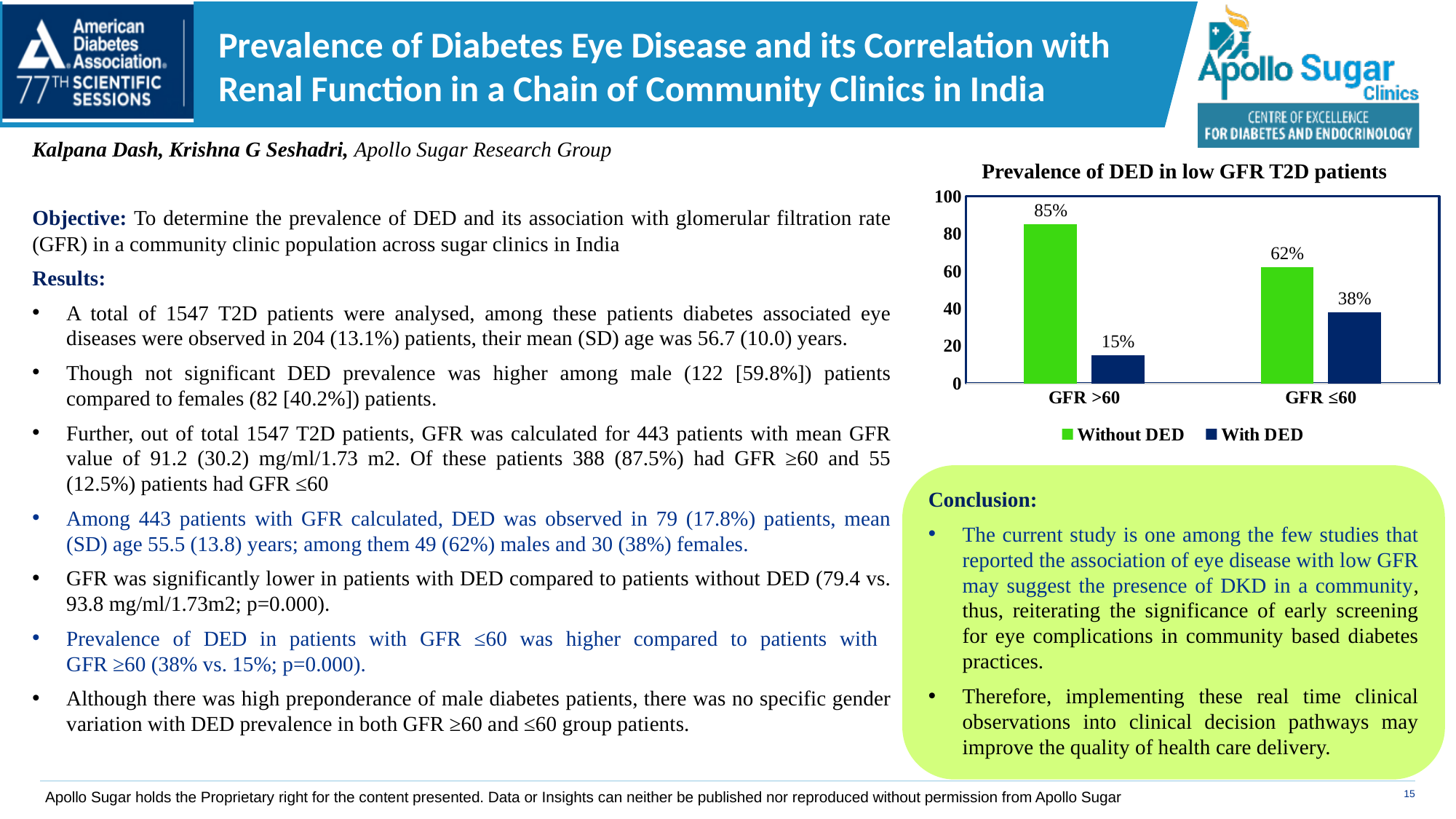
Which is larger: With DED in GFR ≤60 or With DED in GFR >60? With DED in GFR ≤60 What is the difference between the Without DED and With DED values in the GFR ≤60 group? 24% What is the value for Without DED in the GFR >60 group? 85% What is the value for With DED in the GFR >60 group? 15% Which group has the lowest With DED value? GFR >60 What is the value for With DED in the GFR ≤60 group? 38% Which group has the highest Without DED value? GFR >60 What is the title of the chart? Prevalence of DED in low GFR T2D patients What is the value for Without DED in the GFR ≤60 group? 62% How many groups are shown on the x axis of the chart? 2 What kind of chart is shown on the slide? Bar chart How many series does the chart legend list? 2